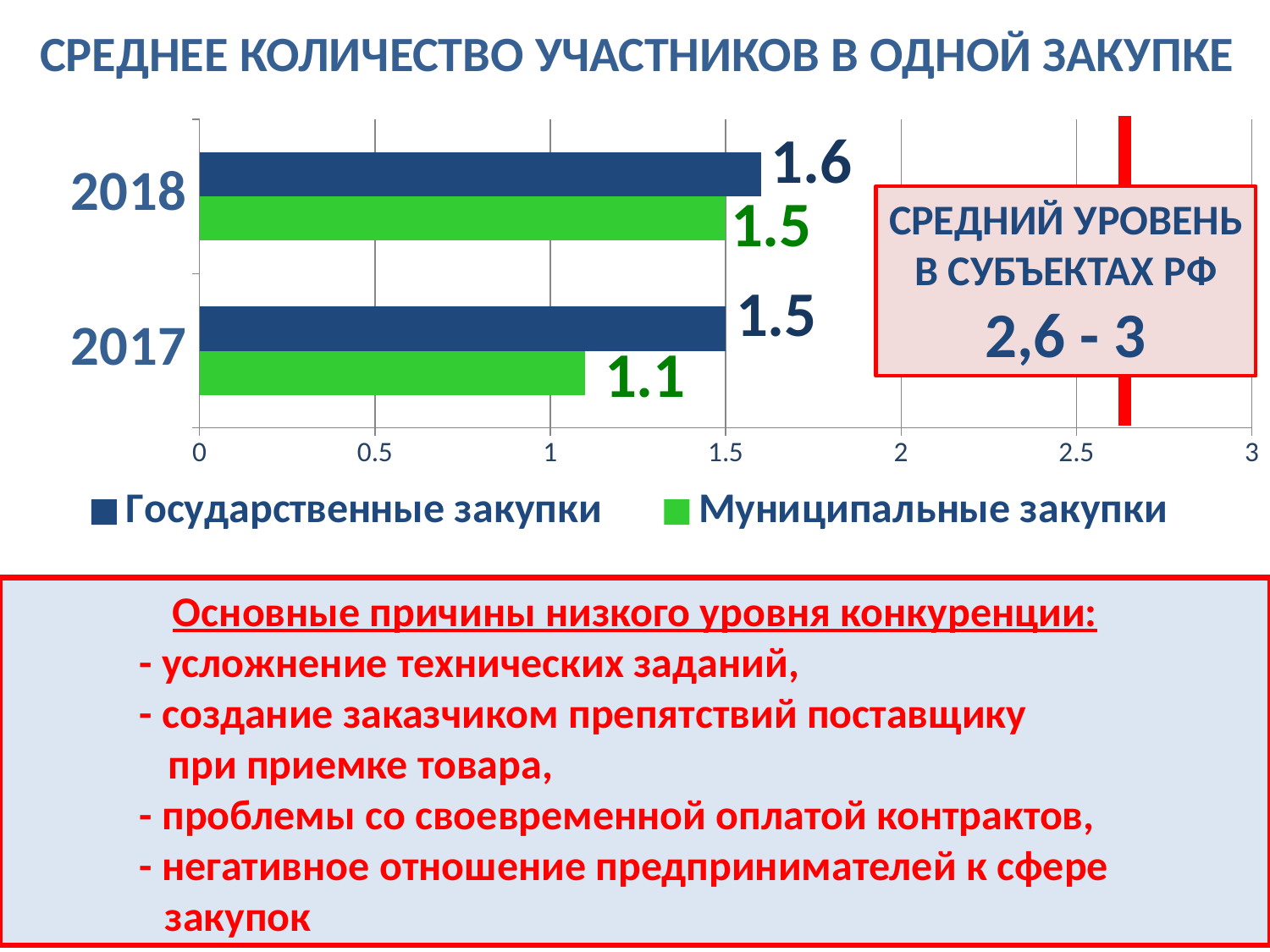
What is the value for Государственные закупки in 2018? 1.6 What is the value for Муниципальные закупки in 2017? 1.1 Which is larger in 2017: Государственные закупки or Муниципальные закупки? Государственные закупки How many years are shown on the chart? 2 Is the value for Государственные закупки in 2018 greater or less than 2? less What is the value for Муниципальные закупки in 2018? 1.5 What kind of chart is shown on the slide? bar chart What is the value for Государственные закупки in 2017? 1.5 How many series does the legend list? 2 What is the difference between Государственные закупки and Муниципальные закупки in 2017? 0.4 Which year has the highest value for Муниципальные закупки? 2018 Which year has the lowest value for Муниципальные закупки? 2017